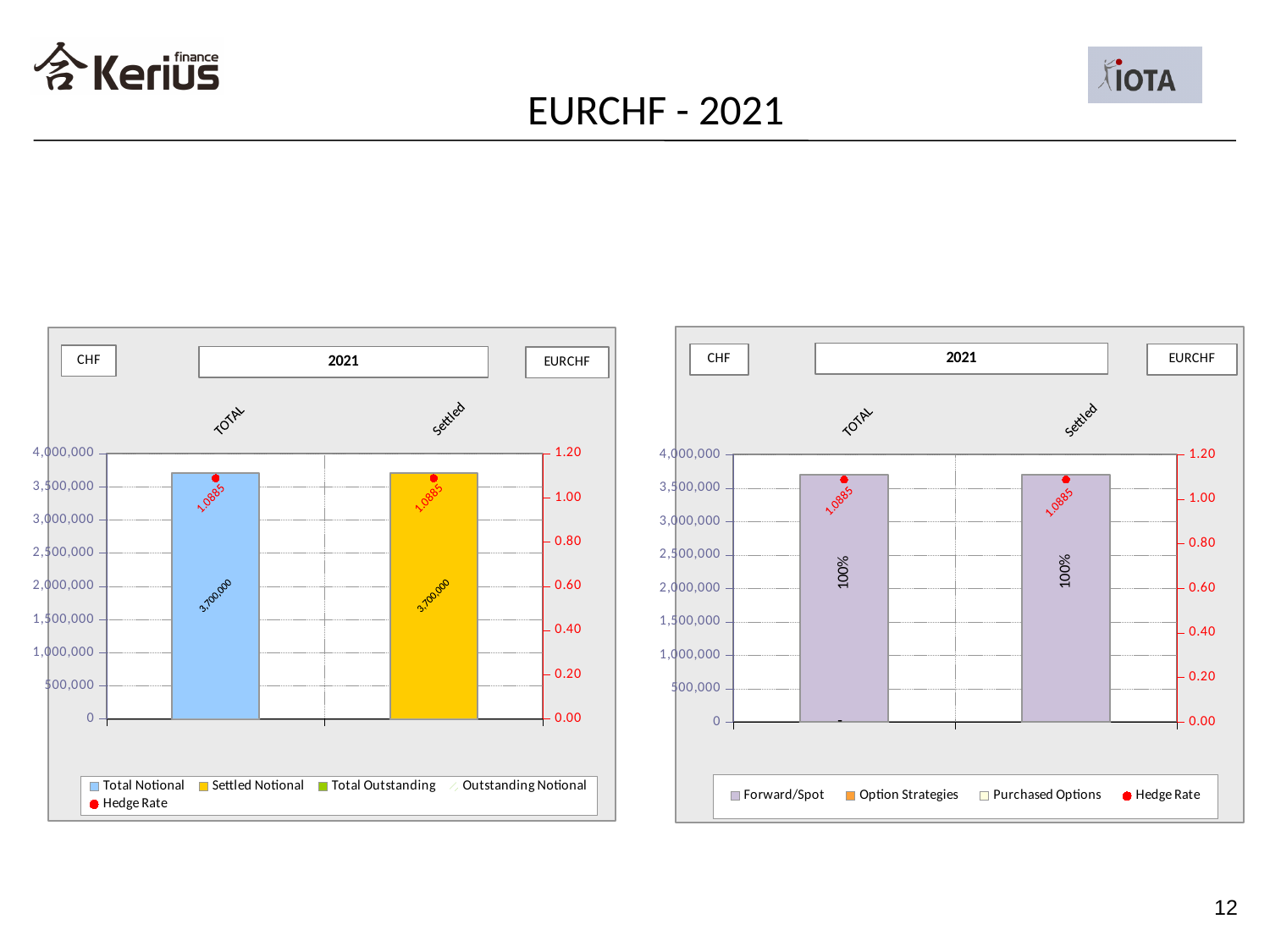
On the left chart, is the value for TOTAL greater or less than 3,500,000? greater What type of chart is the left chart? Combination bar and line chart (bars with Hedge Rate points on a secondary axis) How many categories are shown on the x axis of the left chart? 2 On the left chart, what is the difference between the TOTAL bar and the Settled bar? 0 On the left chart, what is the Hedge Rate shown for TOTAL? 1.0885 How many series does the legend of the left chart list? 5 On the right chart, what percentage label is shown on the Forward/Spot bar for TOTAL? 100% On the right chart, what is the Hedge Rate shown for Settled? 1.0885 How many series does the legend of the right chart list? 4 On the left chart, what is the Settled Notional value for Settled? 3,700,000 On the right chart, is the value for Settled greater or less than 4,000,000? less On the left chart, what is the Total Notional value for TOTAL? 3,700,000